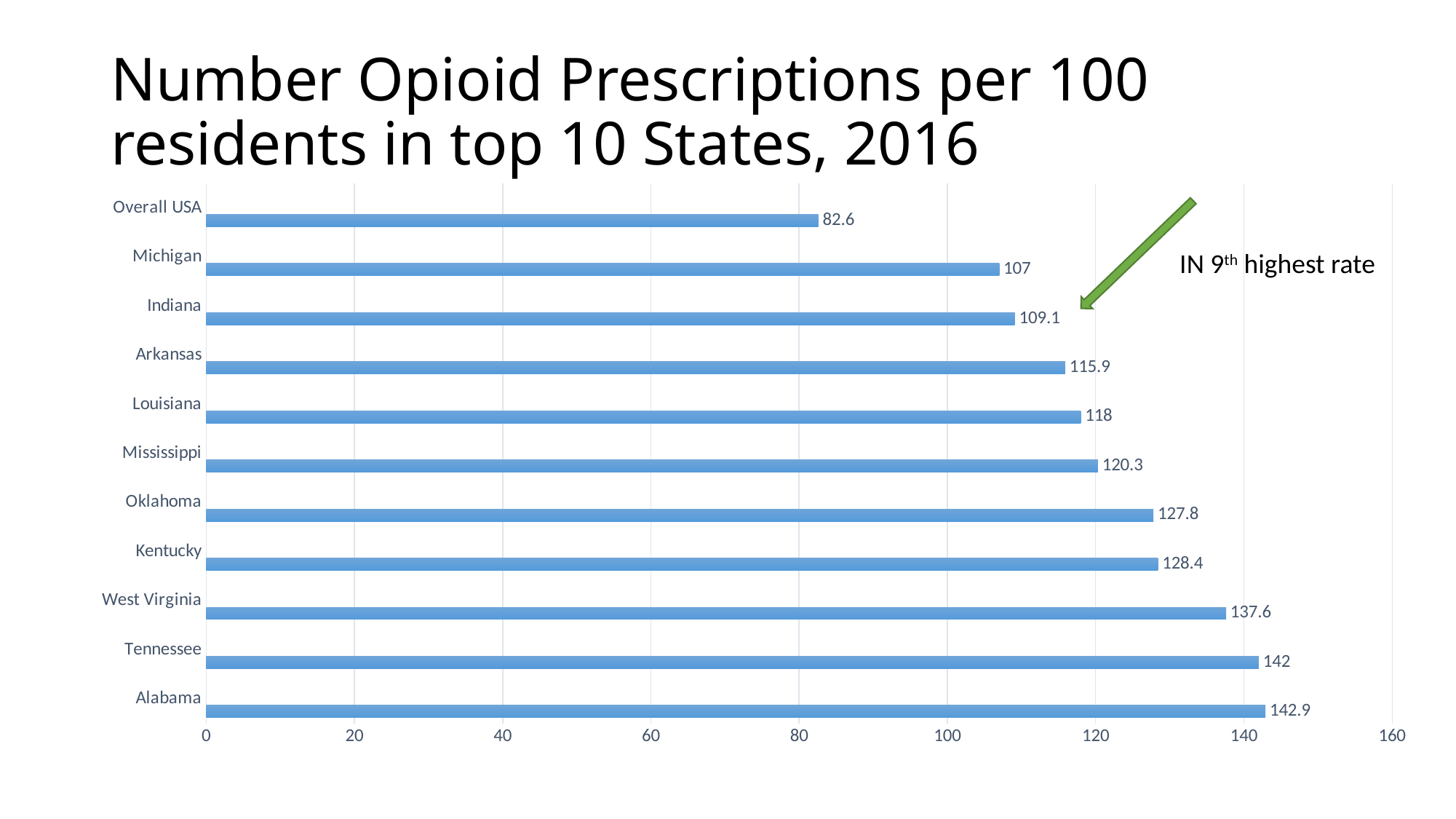
What is the value for West Virginia? 137.6 What is the value for Overall USA? 82.6 What kind of chart is shown on the slide? bar chart What is the title of the chart? Number Opioid Prescriptions per 100 residents in top 10 States, 2016 Which is larger, the value for Michigan or the value for Arkansas? Arkansas What is the difference between the values for Alabama and Overall USA? 60.3 What is the value for Indiana? 109.1 How many categories are shown on the chart? 11 Which category has the lowest value? Overall USA What is the difference between the values for Kentucky and Oklahoma? 0.6 Which category has the highest value? Alabama Is the value for Mississippi greater or less than 100? greater